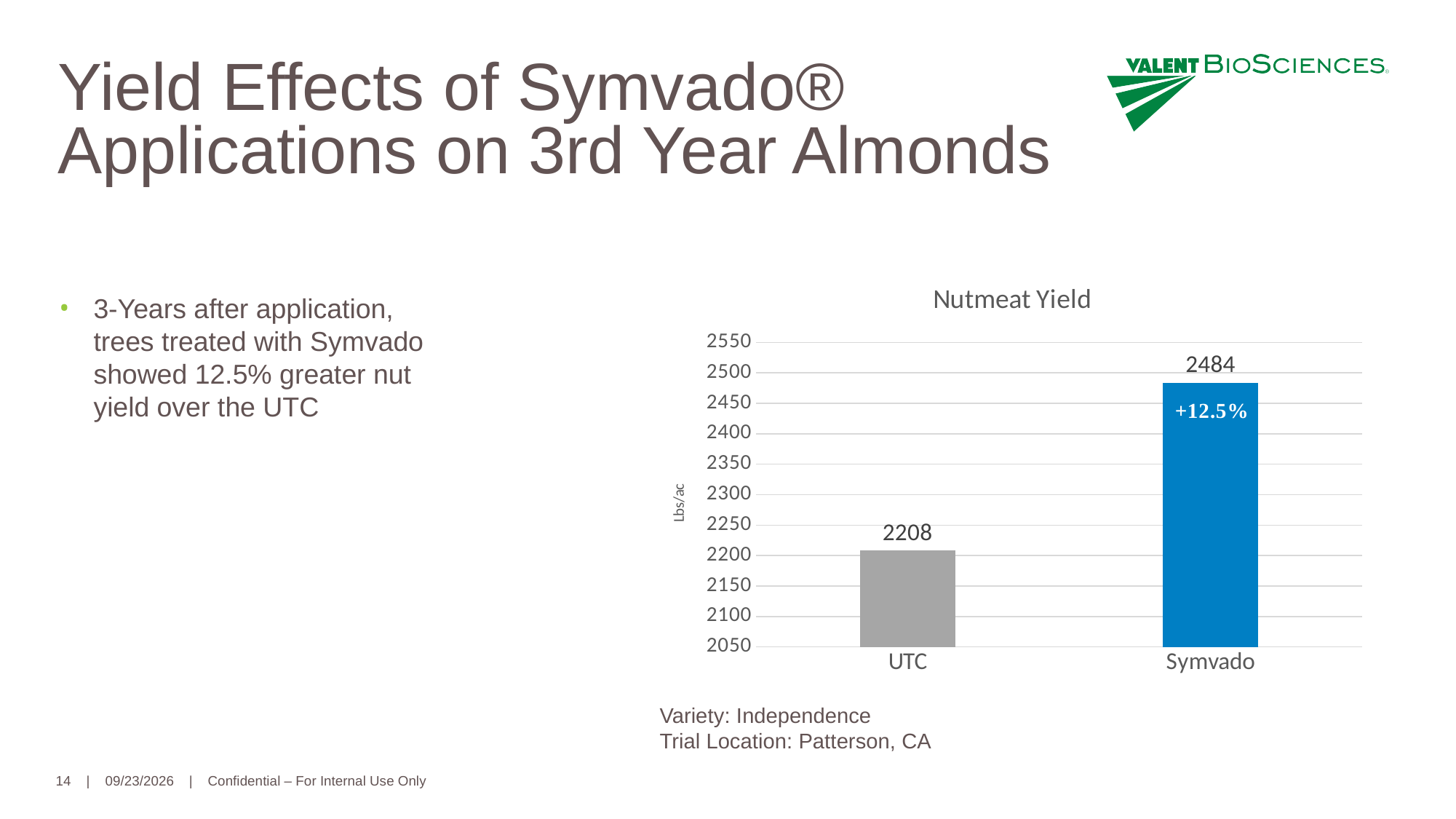
Which category has the lowest nutmeat yield? UTC What is the nutmeat yield for UTC? 2208 How many categories are shown in the chart? 2 Which category has the highest nutmeat yield? Symvado Which has a larger nutmeat yield, UTC or Symvado? Symvado What kind of chart is shown on the slide? Bar chart Is the value for UTC greater or less than 2300? less What is the difference in nutmeat yield between Symvado and UTC? 276 What is the nutmeat yield for Symvado? 2484 Is the value for Symvado greater or less than 2400? greater What percentage increase is labeled on the Symvado bar? +12.5% What is the title of the chart? Nutmeat Yield